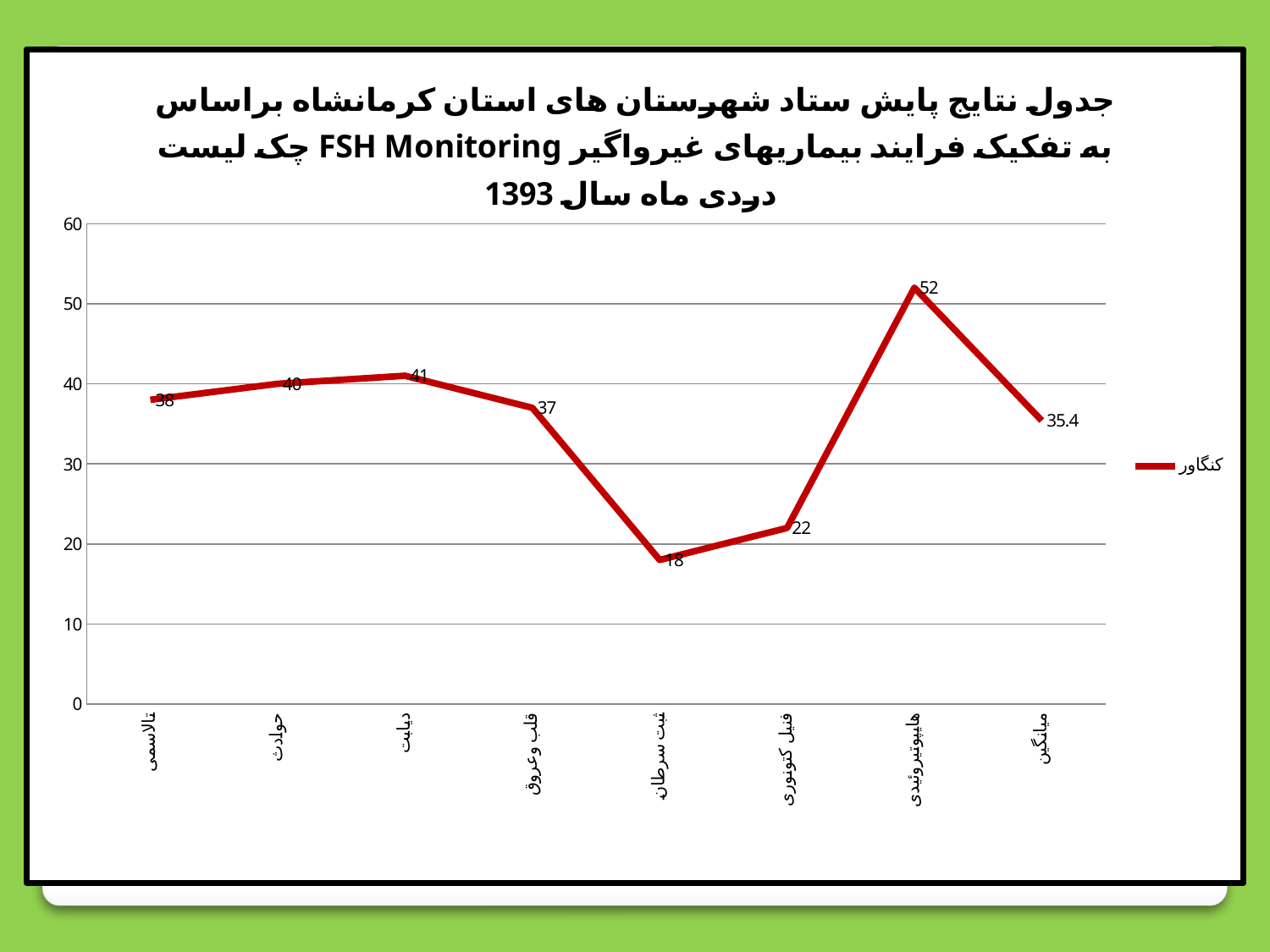
Which category has the lowest value? ثبت سرطان What series name does the legend show? کنگاور What is the value for تالاسمی? 38 How many categories are shown on the x axis? 8 What kind of chart is shown on the slide? line chart What is the difference between the values for هایپوتیروئیدی and ثبت سرطان? 34 Is the value for قلب و عروق greater or less than 30? greater Which is larger, the value for دیابت or the value for فنیل کتونوری? دیابت What is the value for ثبت سرطان? 18 What is the value for میانگین? 35.4 Which category has the highest value? هایپوتیروئیدی What is the value for هایپوتیروئیدی? 52